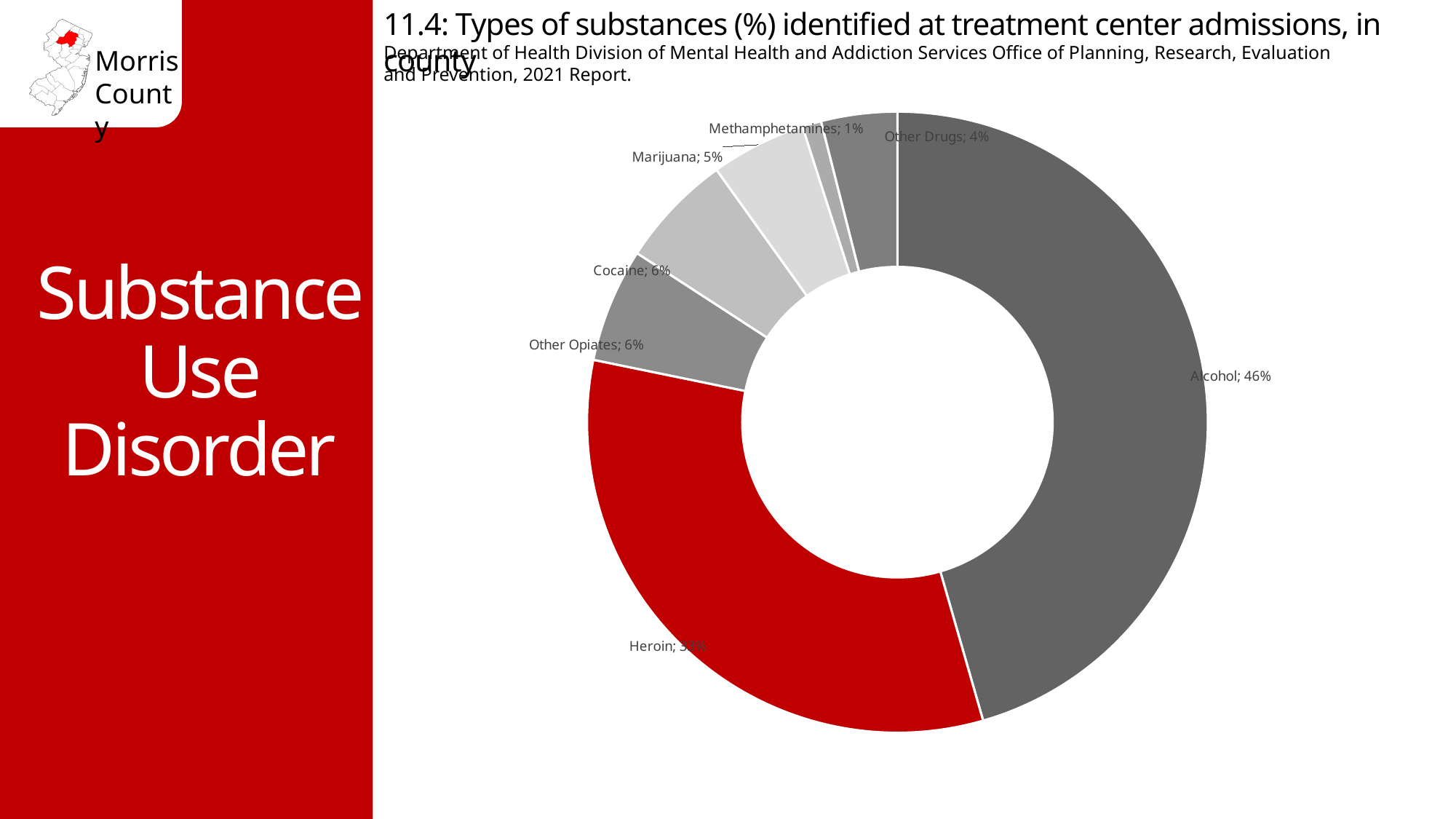
Which has a larger share, Alcohol or Heroin? Alcohol How many percentage points higher is Cocaine than Methamphetamines? 5 percentage points What percentage of treatment center admissions identified Alcohol? 46% What percentage is shown for Other Opiates? 6% Which has a larger share, Marijuana or Other Drugs? Marijuana What kind of chart is used on this slide? Doughnut (pie) chart Which substance has the largest share of admissions? Alcohol What percentage is shown for Marijuana? 5% How many percentage points higher is Alcohol than Marijuana? 41 percentage points What percentage is shown for Other Drugs? 4% What percentage is shown for Cocaine? 6% What percentage is shown for Methamphetamines? 1%